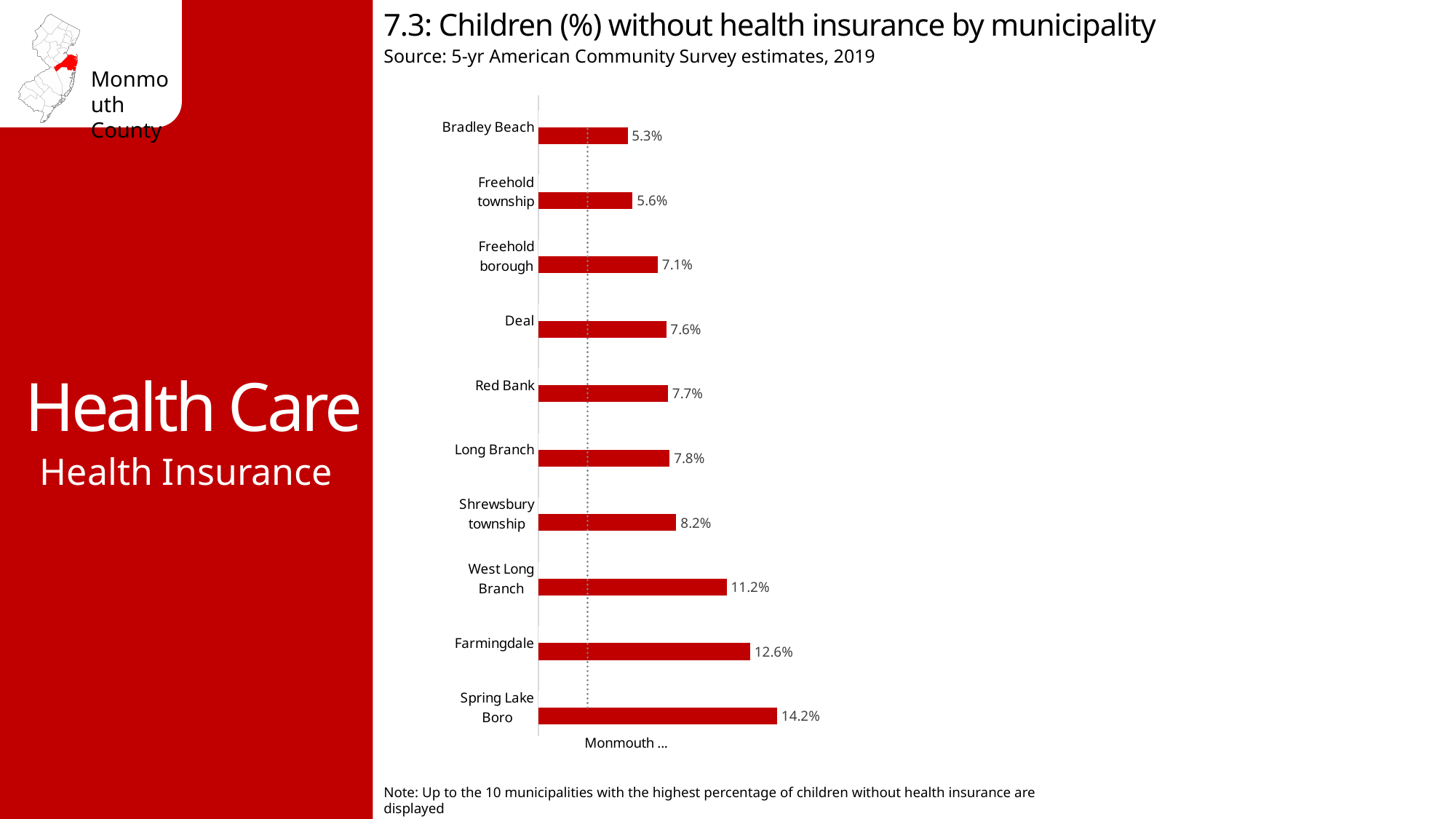
Which has a higher value, Deal or Shrewsbury township? Shrewsbury township What percentage is shown for Freehold township? 5.6% What is the difference between the values for Spring Lake Boro and Bradley Beach? 8.9% What percentage of children are without health insurance in Spring Lake Boro? 14.2% What is the difference between the values for Farmingdale and West Long Branch? 1.4% What is the title of the chart? 7.3: Children (%) without health insurance by municipality Which municipality has the lowest percentage of children without health insurance? Bradley Beach Which municipality has the highest percentage of children without health insurance? Spring Lake Boro How many municipalities are shown in the chart? 10 What is the value shown for Red Bank? 7.7% What kind of chart is shown on the slide? Bar chart Which has a higher value, Freehold borough or Farmingdale? Farmingdale